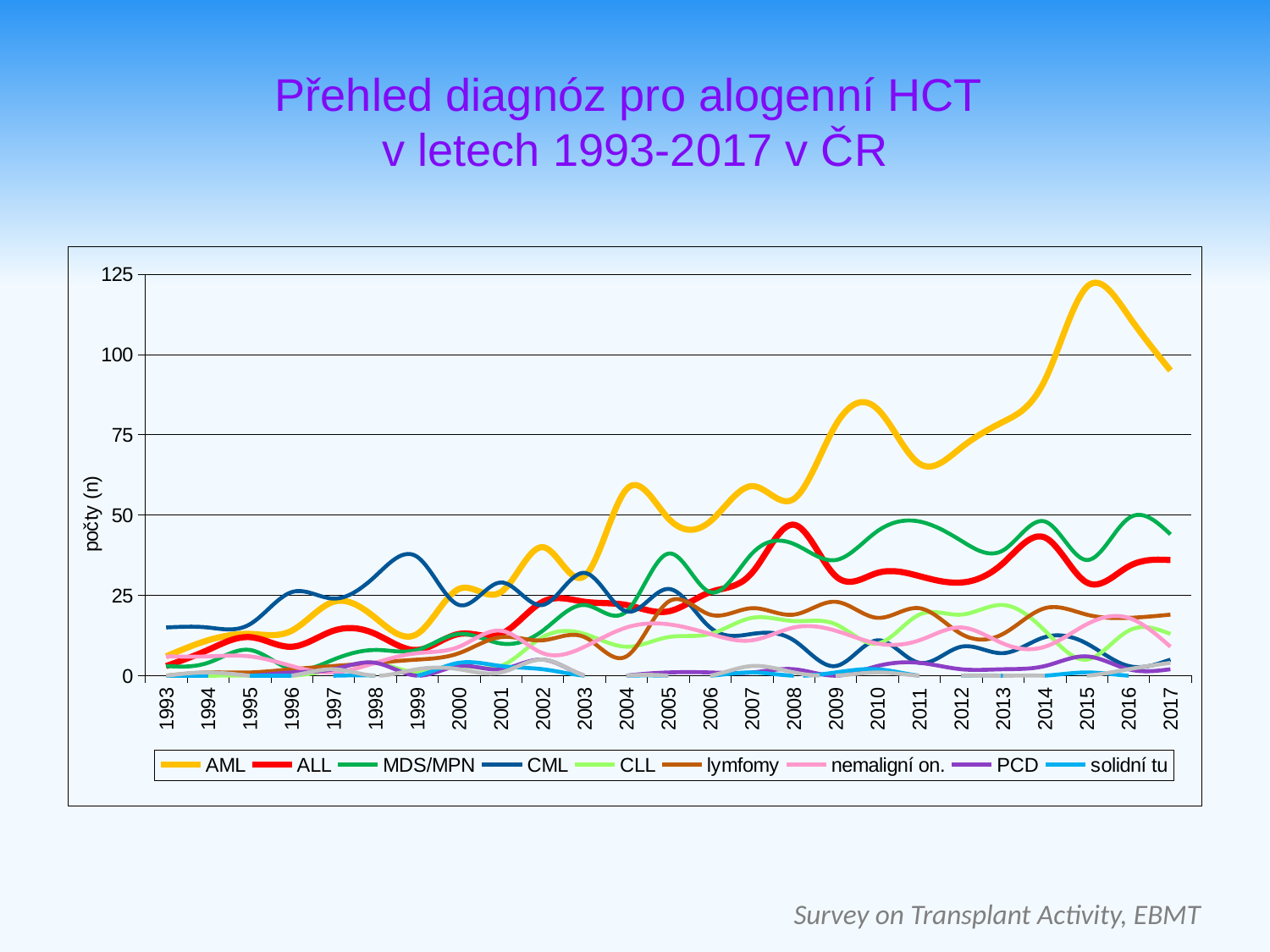
Is the value for AML in 2015 greater or less than 100? greater Which series has the highest value in 2015? AML In 2017, which is larger, the value for AML or the value for MDS/MPN? AML What is the label of the y axis? počty (n) Does the AML series generally rise or fall from 1993 to 2015? rise Is the value for AML in 2010 greater or less than 75? greater Is the value for AML in 2017 greater or less than 100? less How many series does the legend list? 9 What kind of chart is shown on the slide? line chart How many years are shown along the x axis? 25